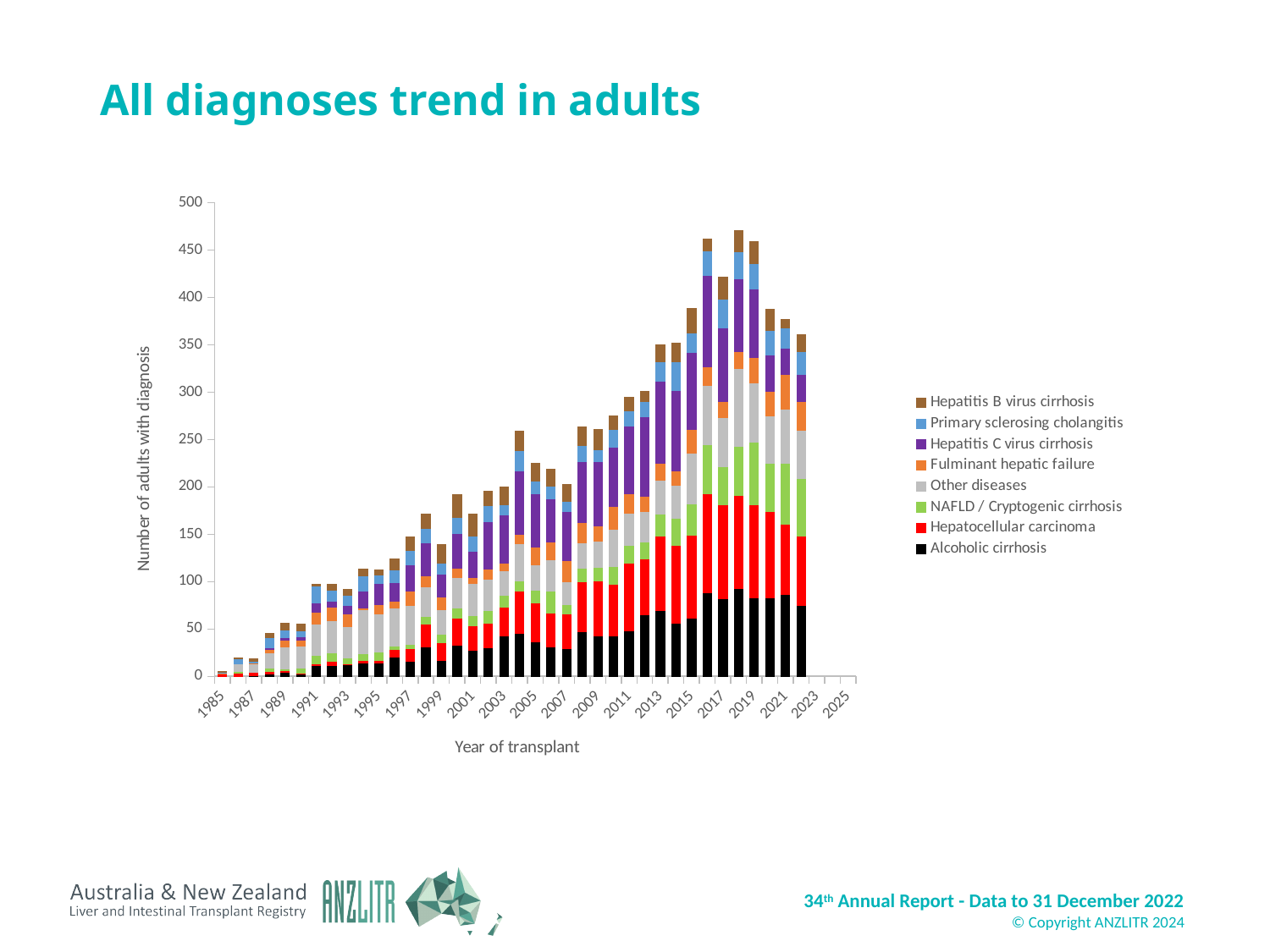
What is the label of the vertical axis? Number of adults with diagnosis Does the total number of adults with a diagnosis generally rise or fall from 1985 to 2018? rise Is the total for 2018 greater or less than 450? greater Which year has the lowest total number of adults with a diagnosis? 1985 Is the total for 2022 greater or less than 400? less What is the title of the chart? All diagnoses trend in adults Is the total for 2013 greater or less than 300? greater Which series is plotted at the bottom of each stacked bar? Alcoholic cirrhosis What kind of chart is shown on the slide? Stacked bar chart How many series does the legend list? 8 Which year has the larger total, 2010 or 2022? 2022